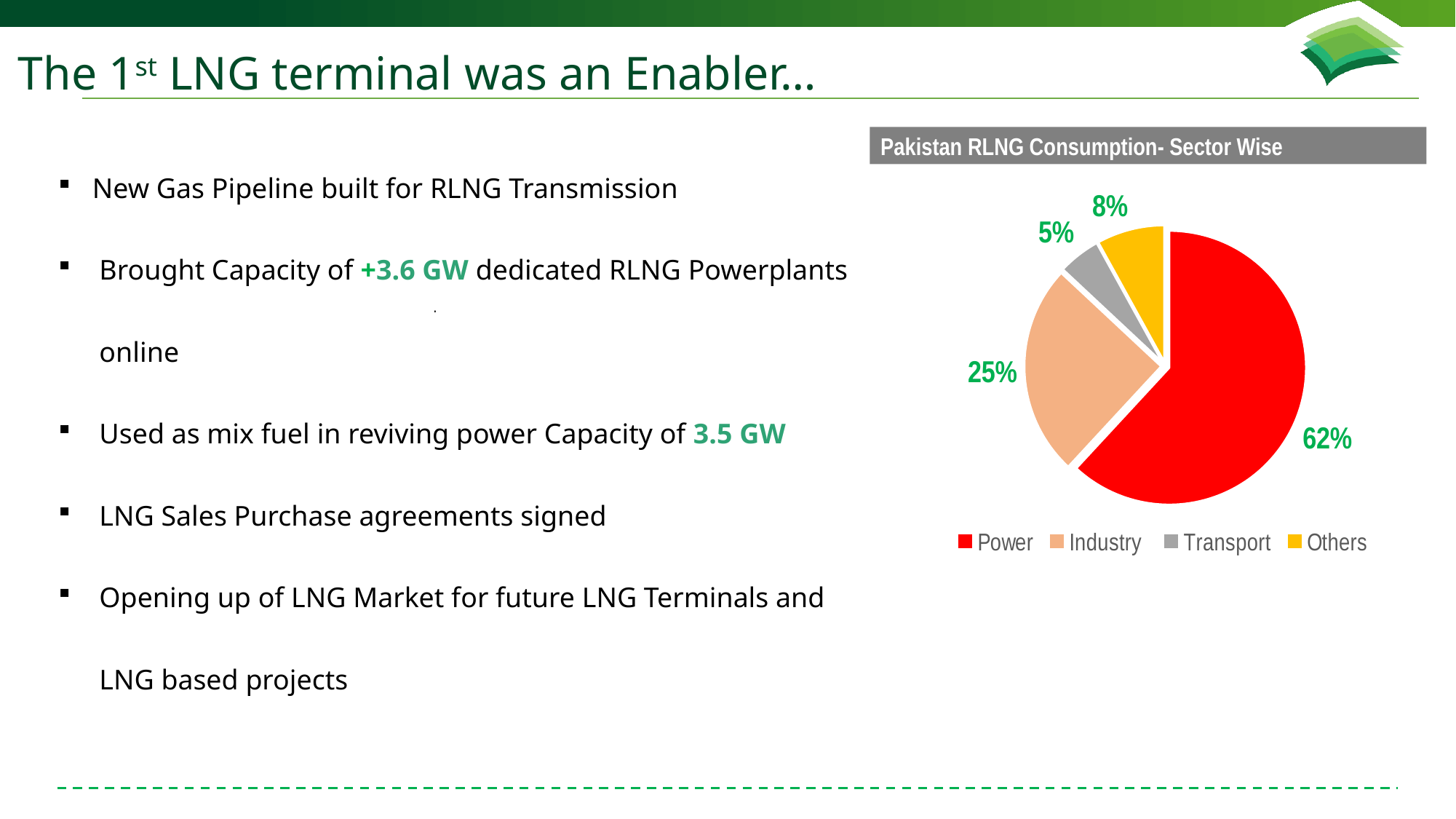
What is the difference in percentage points between the Power and Industry shares? 37 What type of chart is shown on the slide? Pie chart Which has a larger share, Others or Transport? Others What share of RLNG consumption does the Transport sector account for? 5% How many sectors are shown in the pie chart? 4 What share of RLNG consumption does the Industry sector account for? 25% What colour represents the Industry sector in the pie chart? Light orange Which sector has the largest share of RLNG consumption? Power What share of RLNG consumption does the Power sector account for? 62% What is the title of the chart? Pakistan RLNG Consumption- Sector Wise What share of RLNG consumption does the Others category account for? 8% Which sector has the smallest share of RLNG consumption? Transport